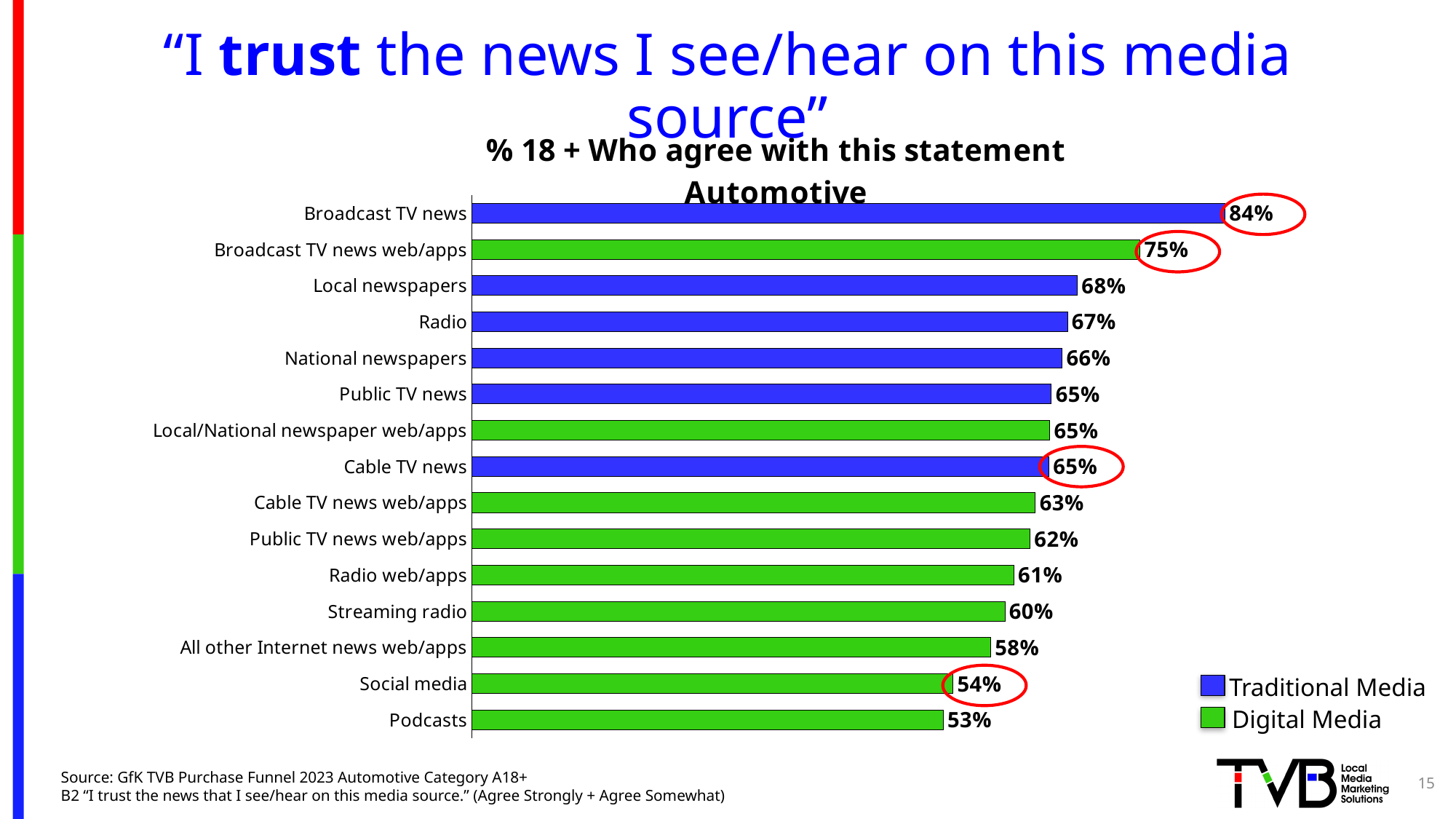
Which colour represents Digital Media in the legend? Green What is the difference between the values for Broadcast TV news and Broadcast TV news web/apps? 9% What is the difference between the values for Local newspapers and Podcasts? 15% How many series does the legend list? 2 What is the value shown for Social media? 54% What is the value shown for Radio web/apps? 61% How many media sources are shown in the chart? 15 Which media source has the lowest percentage of agreement? Podcasts What kind of chart is shown on the slide? Bar chart Which media source has the highest percentage of agreement? Broadcast TV news What percentage of adults 18+ agree they trust the news on Broadcast TV news? 84% Which has a higher value, Cable TV news web/apps or Streaming radio? Cable TV news web/apps